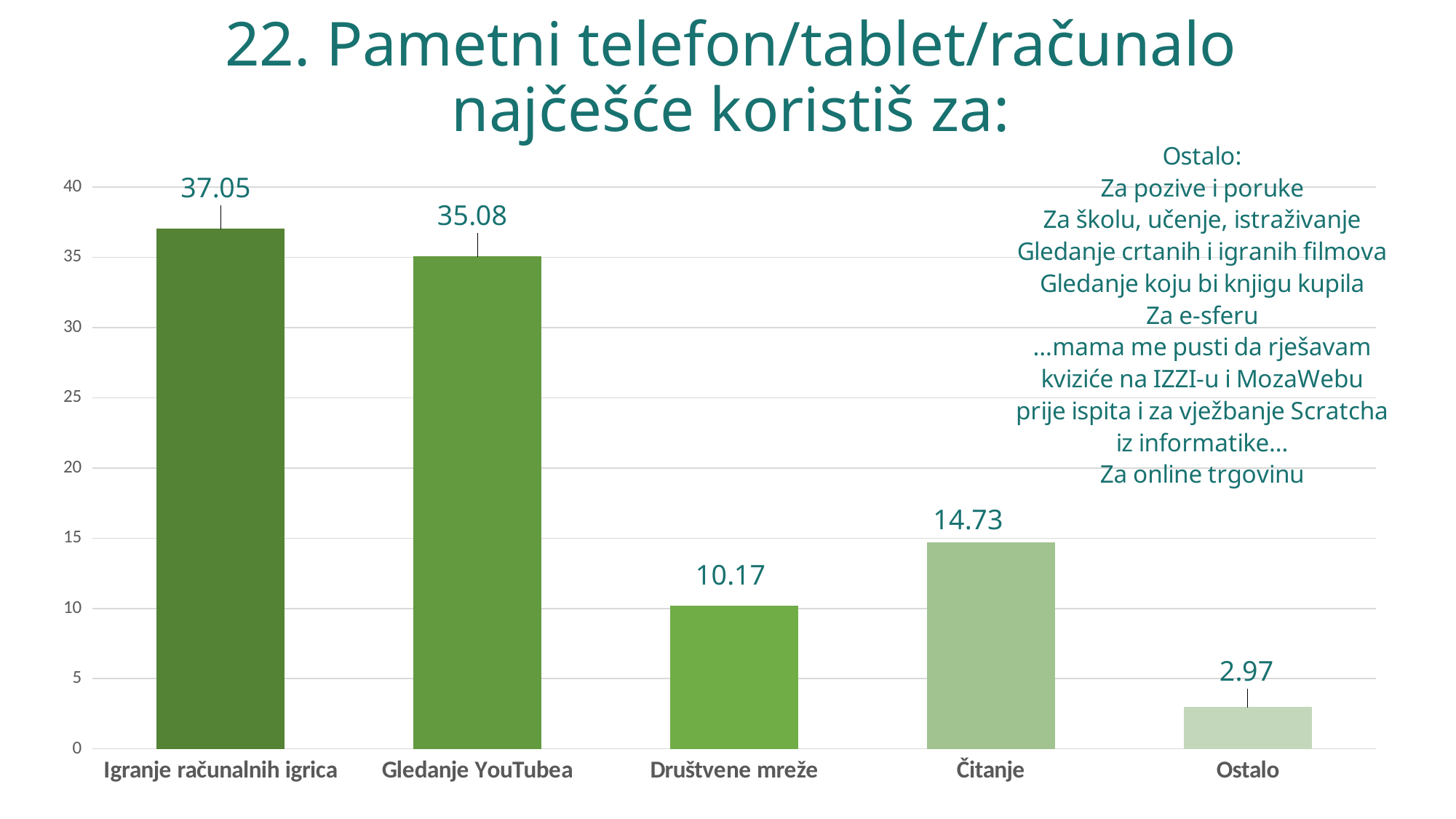
Which category has the highest value? Igranje računalnih igrica What kind of chart is shown on the slide? bar chart Which is larger, the value for Čitanje or the value for Društvene mreže? Čitanje How many categories are shown on the chart? 5 What is the value for Čitanje? 14.73 What is the value for Gledanje YouTubea? 35.08 What is the value for Ostalo? 2.97 What is the difference between the values for Igranje računalnih igrica and Gledanje YouTubea? 1.97 What is the value for Igranje računalnih igrica? 37.05 Which category has the lowest value? Ostalo What is the value for Društvene mreže? 10.17 What is the title of the chart? 22. Pametni telefon/tablet/računalo najčešće koristiš za: